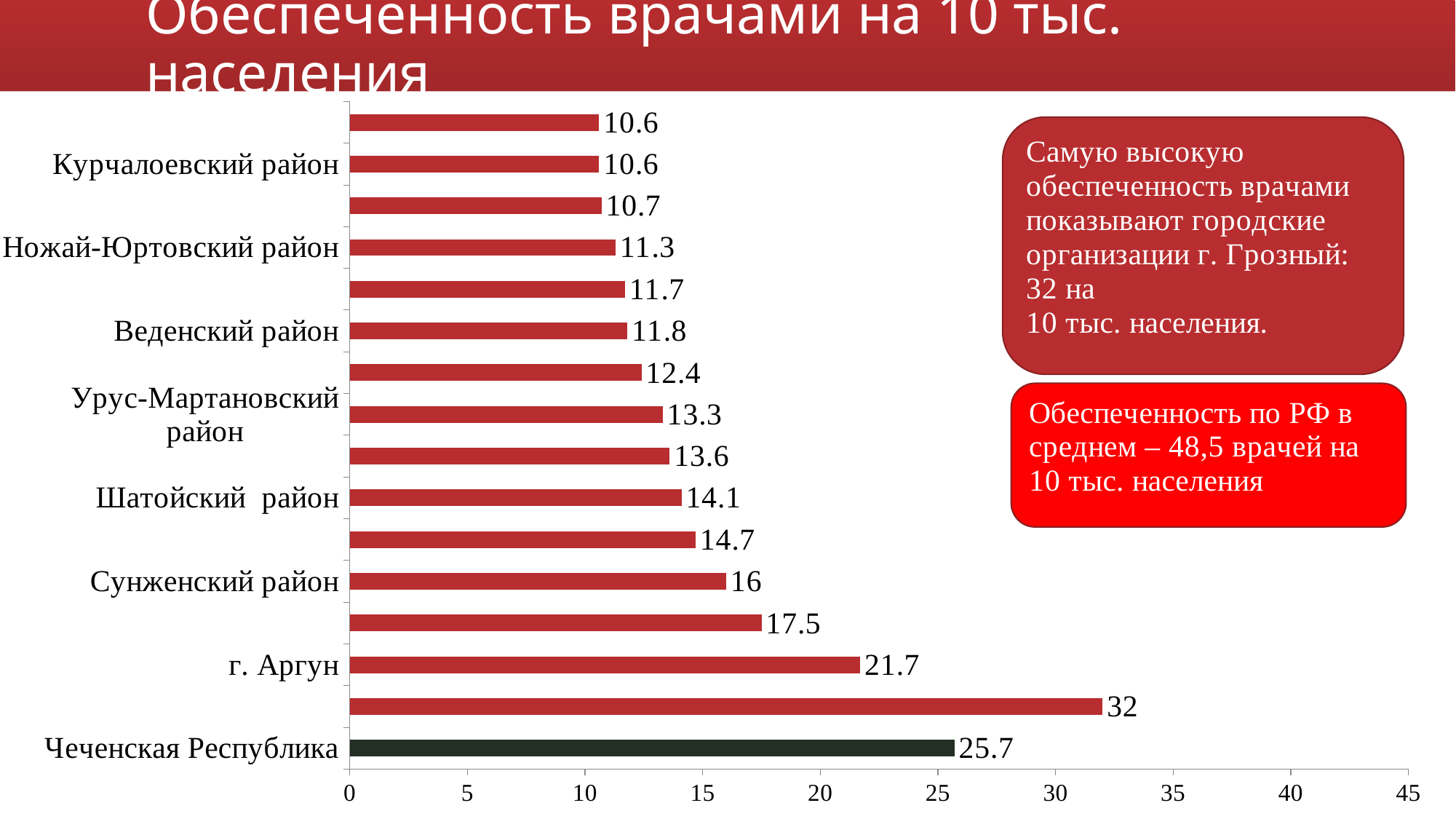
What is the value for Шатойский район? 14.1 What kind of chart is shown on the slide? bar chart What is the value for Чеченская Республика? 25.7 What is the value for Курчалоевский район? 10.6 What is the difference between the values for Чеченская Республика and г. Аргун? 4 Which has a larger value, Сунженский район or Шатойский район? Сунженский район What is the highest value shown on the chart? 32 How many bars are plotted on the chart? 16 What is the value for г. Аргун? 21.7 What is the value for Урус-Мартановский район? 13.3 What is the value for Сунженский район? 16 What is the value for Ножай-Юртовский район? 11.3